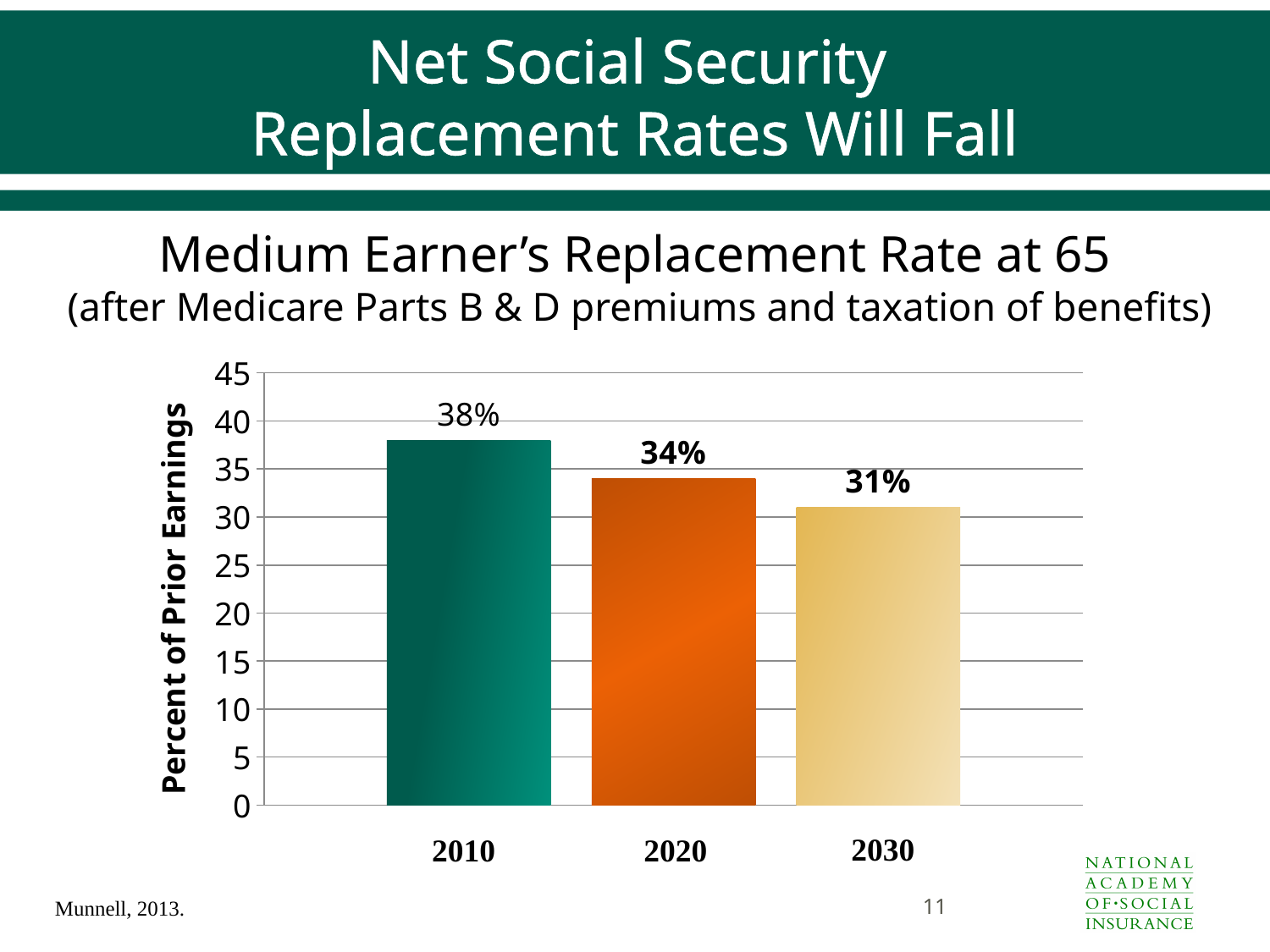
What is the difference in percentage points between the 2010 and 2030 replacement rates? 7 What kind of chart is shown on the slide? bar chart What is the replacement rate shown for 2010? 38% Which is larger, the replacement rate for 2020 or for 2030? 2020 Which year has the lowest replacement rate? 2030 What is the replacement rate shown for 2030? 31% Which year has the highest replacement rate? 2010 How many years are shown on the chart? 3 Do the replacement rates rise or fall from 2010 to 2030? fall What is the replacement rate shown for 2020? 34% What is the difference in percentage points between the 2010 and 2020 replacement rates? 4 Is the value for 2030 greater or less than 35? less